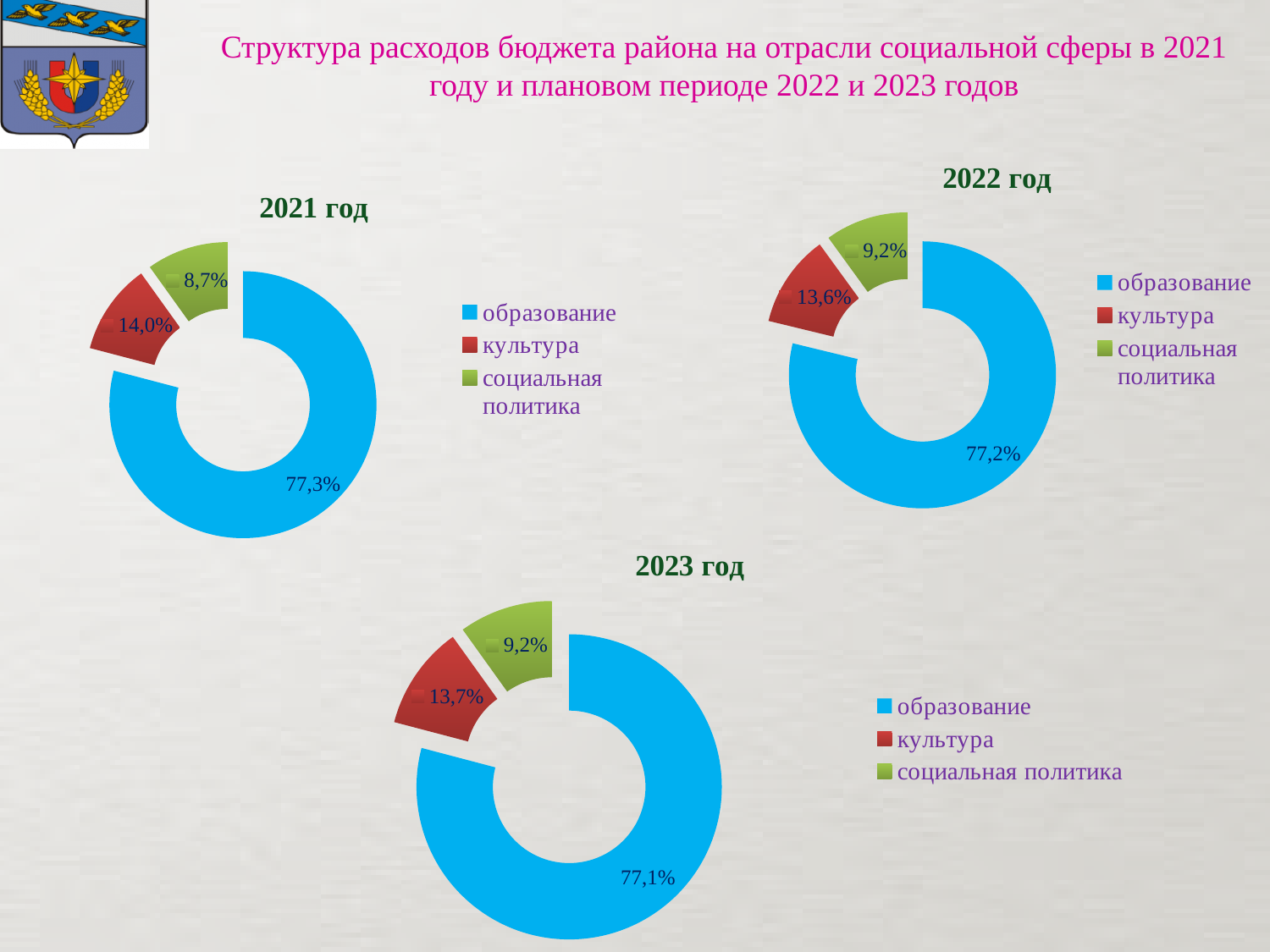
In the "2021 год" chart, which category has the smallest share? социальная политика In the "2022 год" chart, what colour represents образование? blue In the "2022 год" chart, what is the difference between the shares of культура and социальная политика? 4,4% In the "2021 год" chart, which is larger: the share of культура or the share of социальная политика? культура In the "2021 год" chart, what share is shown for образование? 77,3% In the "2023 год" chart, which category has the largest share? образование How many categories does the "2022 год" chart show? 3 In the "2023 год" chart, what share is shown for культура? 13,7% What type of chart is the "2023 год" chart? doughnut chart How many charts are on the slide? 3 In the "2022 год" chart, what share is shown for социальная политика? 9,2% In the "2021 год" chart, what share is shown for культура? 14,0%